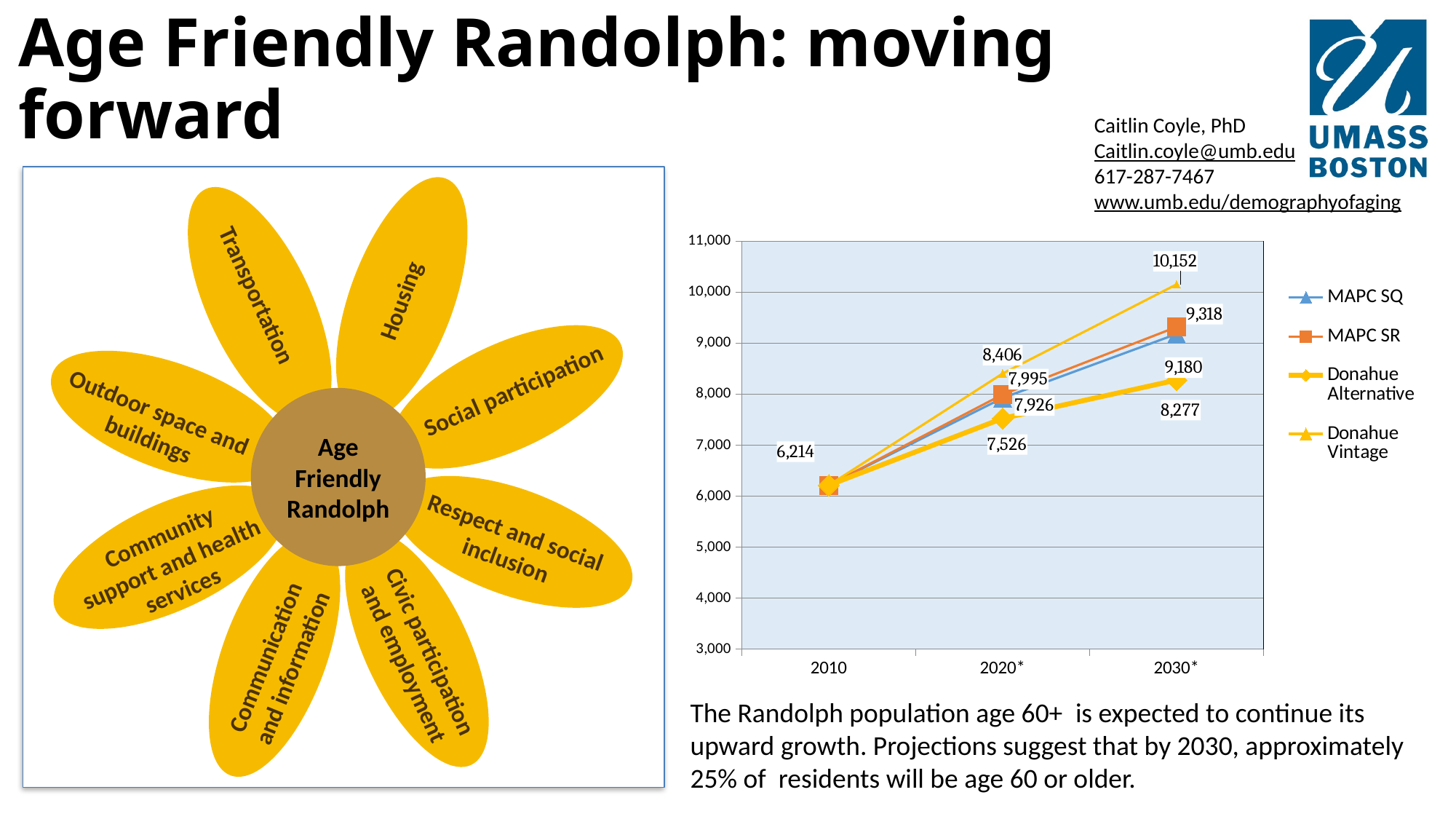
Which series has the highest value in 2030*? Donahue Vintage What is the projected value for Donahue Vintage in 2030*? 10,152 Which series has the lowest value in 2020*? Donahue Alternative What is the difference between the Donahue Vintage and MAPC SR values in 2030*? 834 Do the values on the line chart rise or fall from 2010 to 2030*? rise How many years are shown on the x axis of the line chart? 3 In 2020*, which is larger: the MAPC SR value or the Donahue Alternative value? MAPC SR Is the Donahue Alternative value for 2030* greater or less than 9,000? less What kind of chart is shown on the right side of the slide? line chart How many series does the legend of the line chart list? 4 What is the value shown for 2010 on the line chart? 6,214 What is the projected value for MAPC SR in 2030*? 9,318